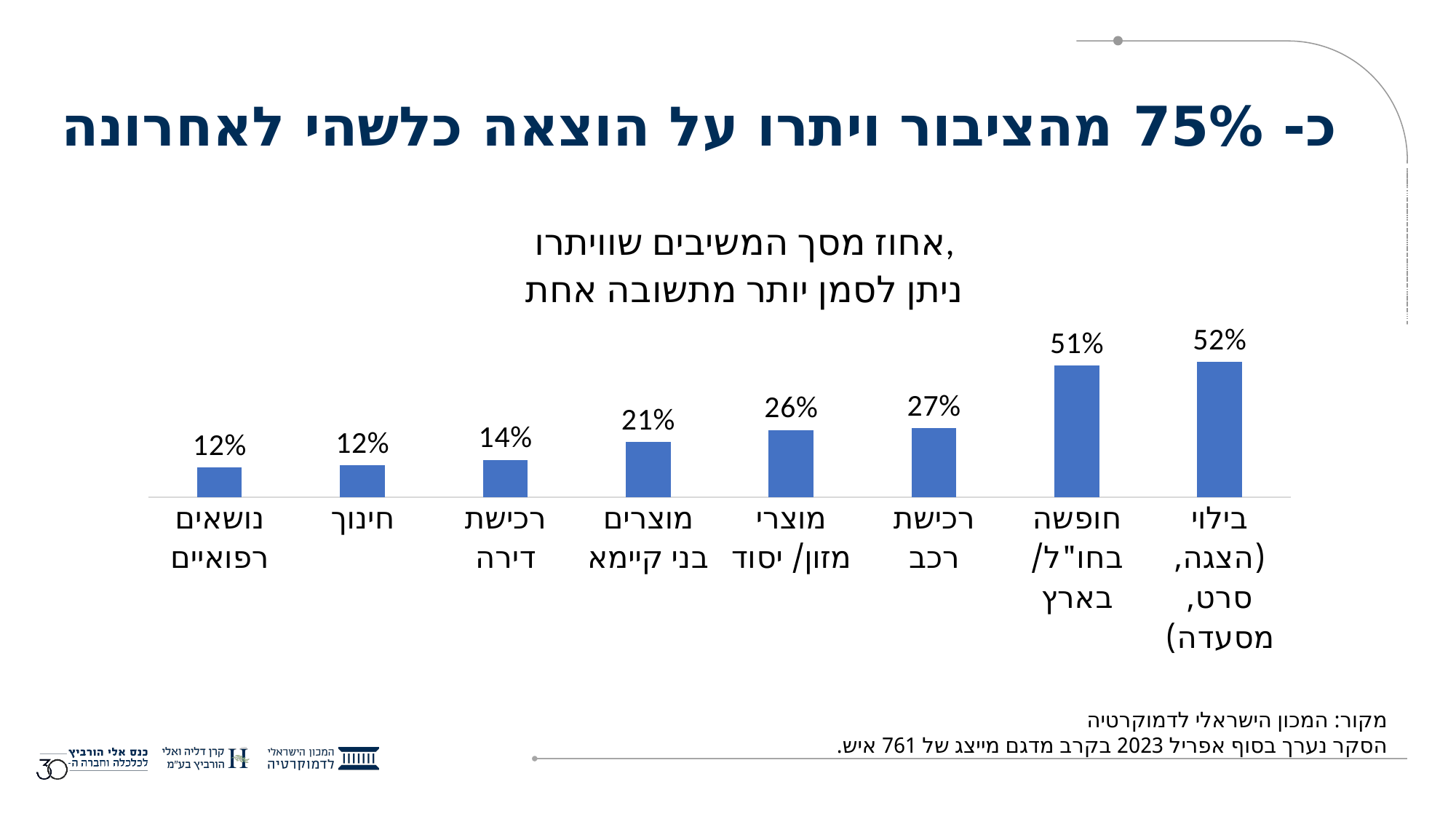
What is the difference between the values for בילוי (הצגה, סרט, מסעדה) and רכישת רכב? 25% What is the value for חופשה בחו"ל/בארץ? 51% Which is larger, the value for מוצרי מזון/יסוד or the value for מוצרים בני קיימא? מוצרי מזון/יסוד What percentage of the public does the slide title say gave up some expense recently? כ- 75% What is the value for רכישת דירה? 14% What is the difference between the values for מוצרי מזון/יסוד and נושאים רפואיים? 14% What is the value for מוצרים בני קיימא? 21% What is the value for חינוך? 12% What is the value for רכישת רכב? 27% Which category has the highest value? בילוי (הצגה, סרט, מסעדה) What type of chart is shown on the slide? bar chart How many categories are shown in the chart? 8